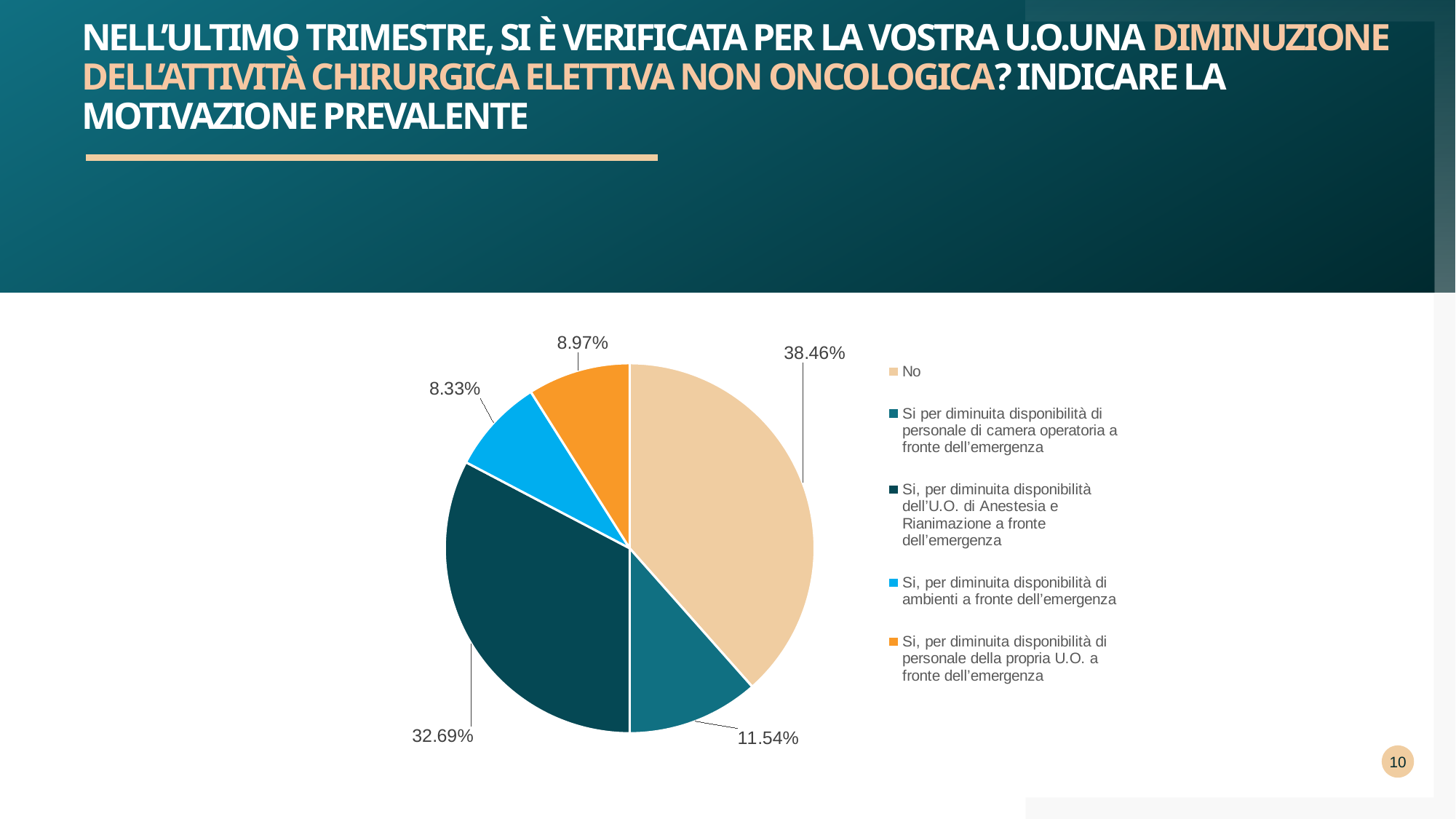
Which is larger: the share for "Si, per diminuita disponibilità di personale della propria U.O. a fronte dell'emergenza" or the share for "Si, per diminuita disponibilità di ambienti a fronte dell'emergenza"? Si, per diminuita disponibilità di personale della propria U.O. a fronte dell'emergenza What percentage is shown for "Si, per diminuita disponibilità dell'U.O. di Anestesia e Rianimazione a fronte dell'emergenza"? 32.69% What percentage is shown for "Si, per diminuita disponibilità di ambienti a fronte dell'emergenza"? 8.33% What type of chart is shown on the slide? pie chart What is the difference in percentage points between "No" and "Si, per diminuita disponibilità dell'U.O. di Anestesia e Rianimazione a fronte dell'emergenza"? 5.77 What colour is the slice representing "No"? beige Which category has the smallest share of the pie? Si, per diminuita disponibilità di ambienti a fronte dell'emergenza What percentage is shown for "Si, per diminuita disponibilità di personale della propria U.O. a fronte dell'emergenza"? 8.97% What percentage of the pie corresponds to "No"? 38.46% What percentage is shown for "Si per diminuita disponibilità di personale di camera operatoria a fronte dell'emergenza"? 11.54% How many slices does the pie chart have? 5 Which category has the largest share of the pie? No